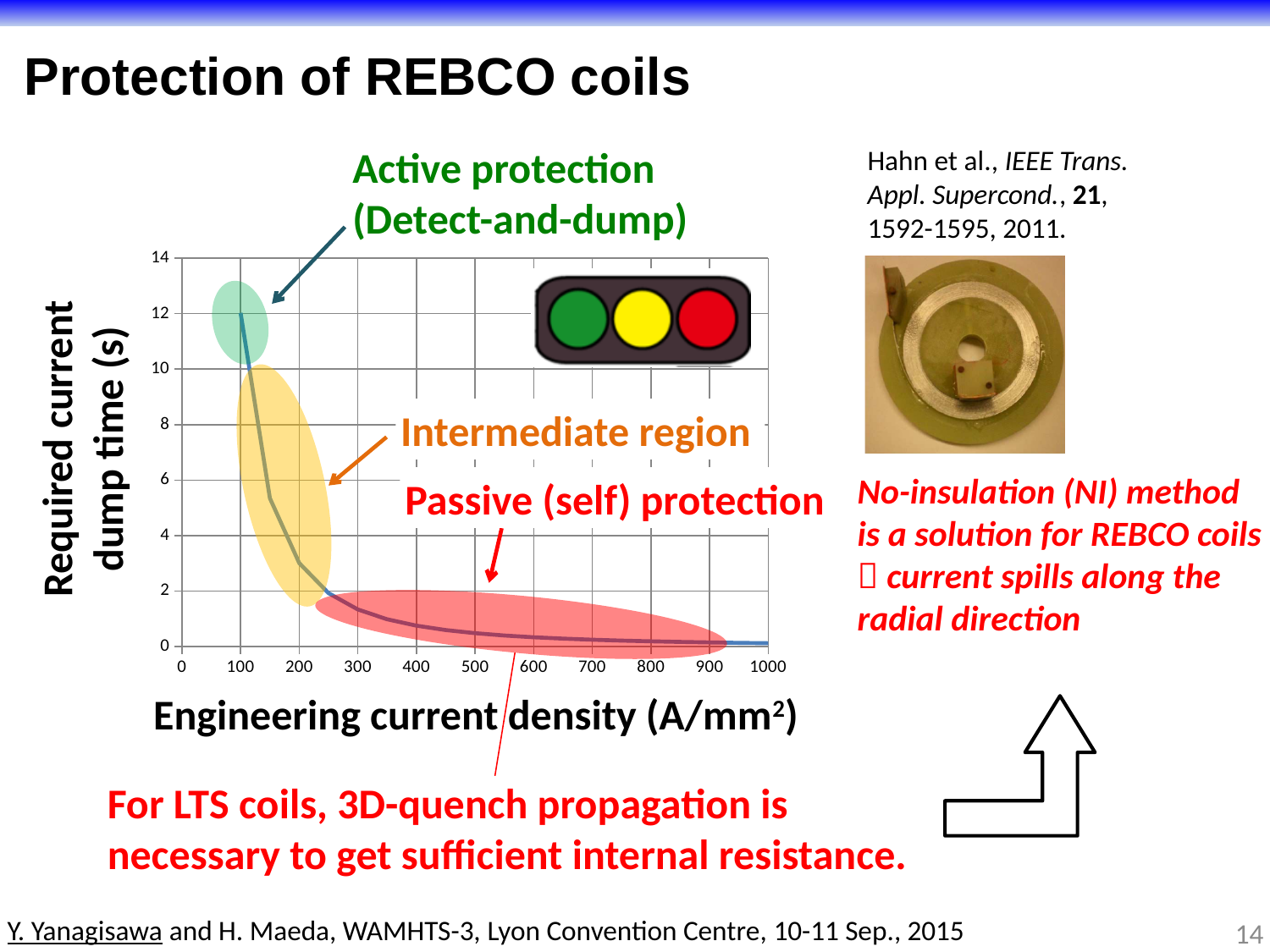
What is the maximum value shown on the x axis of the chart? 1000 What kind of chart is shown on the slide? line chart What is the label of the x axis of the chart? Engineering current density (A/mm²) What is the maximum value shown on the y axis of the chart? 14 Which has the larger required current dump time: an engineering current density of 100 A/mm² or 300 A/mm²? 100 A/mm² Is the required current dump time at an engineering current density of 500 A/mm² greater or less than 2 s? less Is the required current dump time at an engineering current density of 100 A/mm² greater or less than 10 s? greater Is the required current dump time at an engineering current density of 150 A/mm² greater or less than 4 s? greater Does the required current dump time rise or fall as engineering current density increases along the x axis? fall